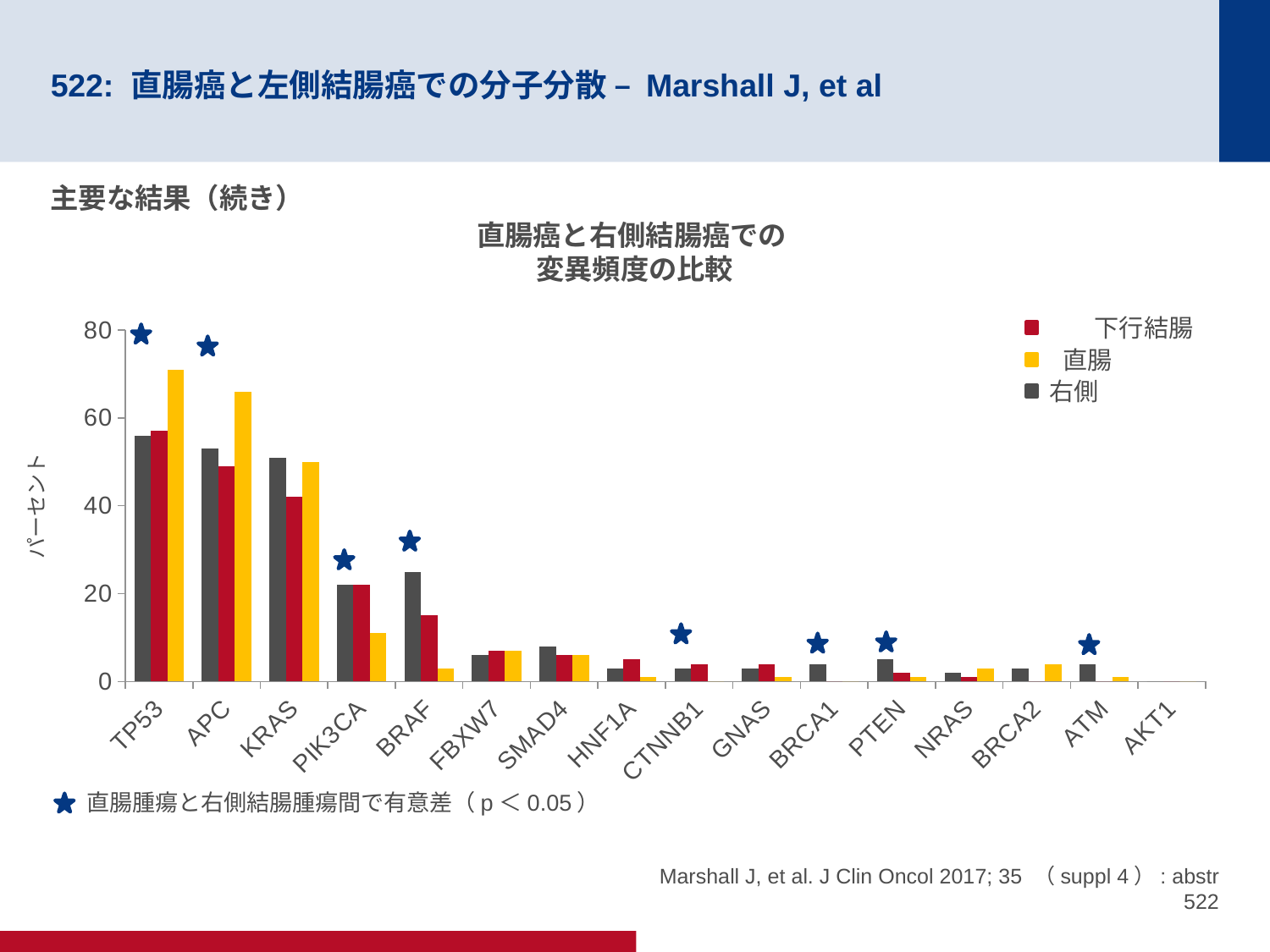
Which colour represents 直腸 in the legend? yellow For TP53, which series has the larger value, 直腸 or 右側? 直腸 Do the values generally rise or fall moving from left to right along the x axis? fall Is the 右側 value for TP53 greater or less than 60? less Is the 直腸 value for PIK3CA greater or less than 20? less For BRAF, which series has the larger value, 右側 or 直腸? 右側 Is the 右側 value for BRAF greater or less than 20? greater How many genes are shown along the x axis? 16 How many series does the legend list? 3 What kind of chart is shown on the slide? bar chart Which gene has the highest 直腸 value? TP53